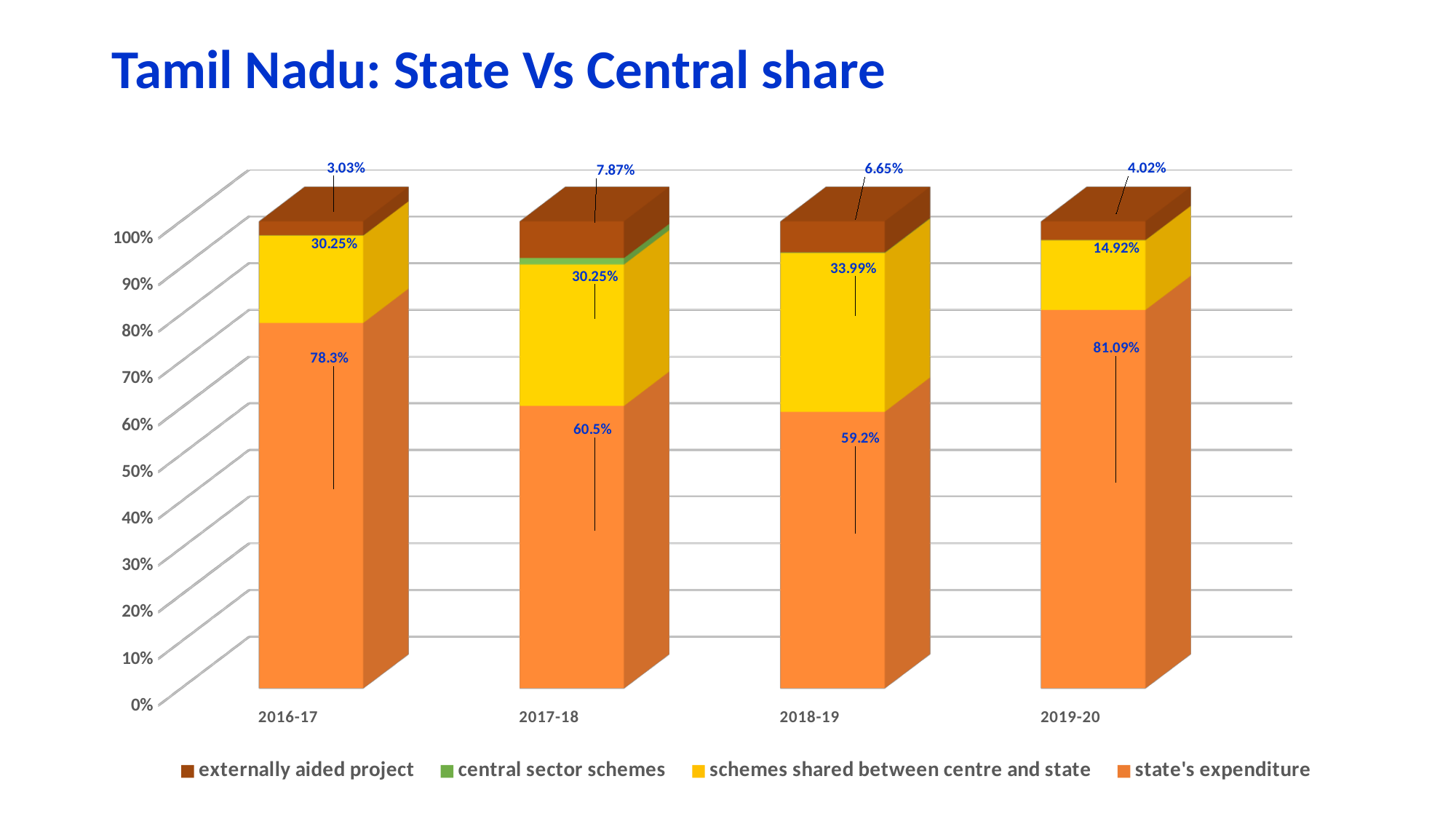
What is the difference between the externally aided project values for 2017-18 and 2016-17? 4.84% How many series does the legend list? 4 How many years are shown on the x axis? 4 What is the value for schemes shared between centre and state in 2018-19? 33.99% What is the value for state's expenditure in 2016-17? 78.3% What kind of chart is shown on the slide? Stacked bar chart What is the value for schemes shared between centre and state in 2019-20? 14.92% What is the value for externally aided project in 2017-18? 7.87% Which year has the lowest value for state's expenditure? 2018-19 Which year has the highest value for state's expenditure? 2019-20 What is the title of the chart? Tamil Nadu: State Vs Central share Which year has the larger value for schemes shared between centre and state, 2018-19 or 2019-20? 2018-19